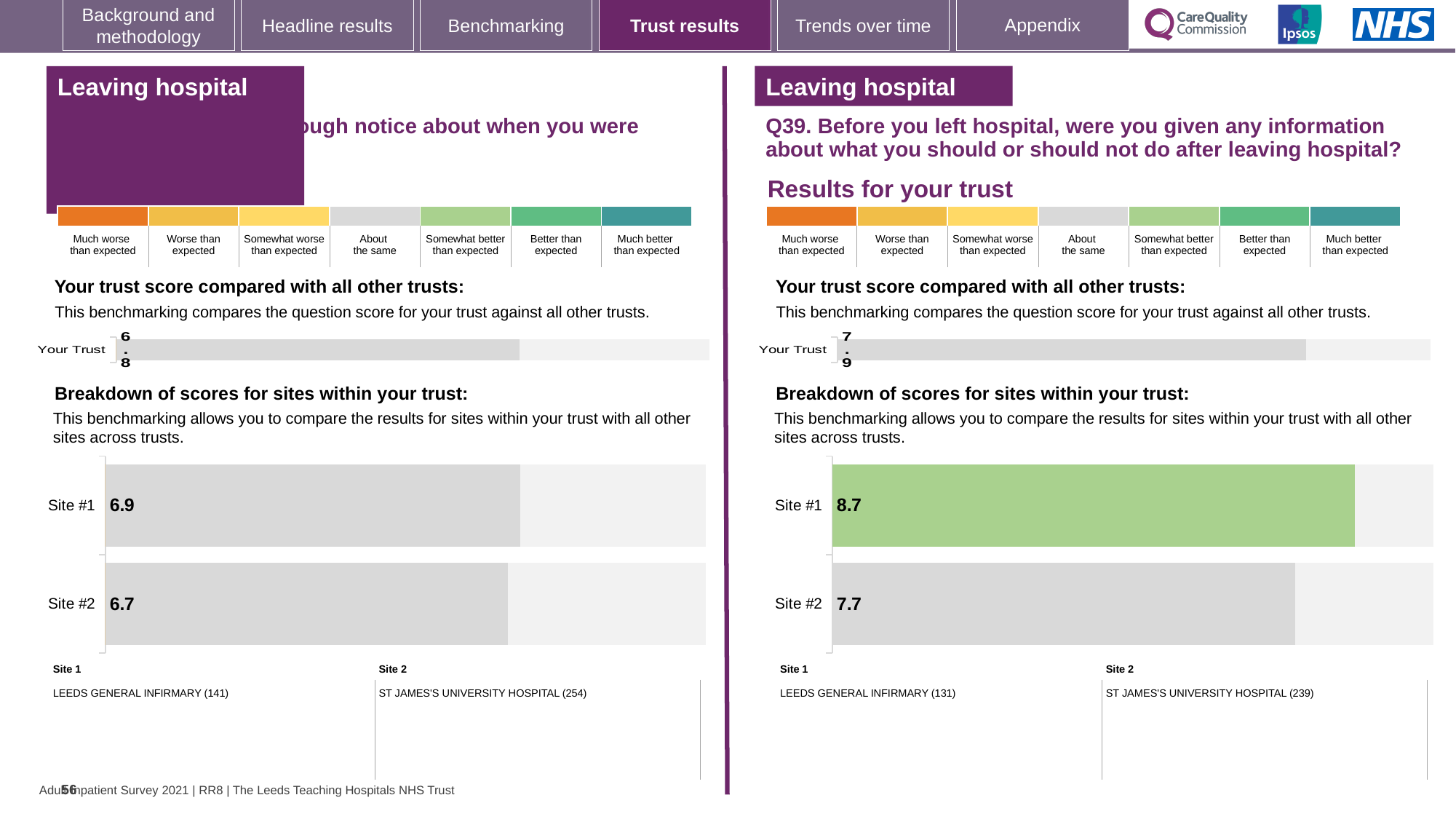
On the left-hand 'Your trust score compared with all other trusts' chart, what is the score for Your Trust? 6.8 On the left-hand site breakdown chart, what is the difference between the Site #1 and Site #2 scores? 0.2 On the left-hand site breakdown chart, how many sites are shown? 2 On the right-hand (Q39) site breakdown chart, what is the difference between the Site #1 and Site #2 scores? 1.0 On the right-hand (Q39) site breakdown chart, what is the score for Site #1? 8.7 On the left-hand site breakdown chart, what is the score for Site #1? 6.9 On the right-hand (Q39) 'Your trust score compared with all other trusts' chart, what is the score for Your Trust? 7.9 On the right-hand (Q39) site breakdown chart, which site has the higher score? Site #1 On the left-hand site breakdown chart, what is the score for Site #2? 6.7 What type of chart is used for the site breakdown on the right-hand (Q39) side? Bar chart On the right-hand (Q39) site breakdown chart, which site's bar is coloured green? Site #1 On the right-hand (Q39) site breakdown chart, what is the score for Site #2? 7.7